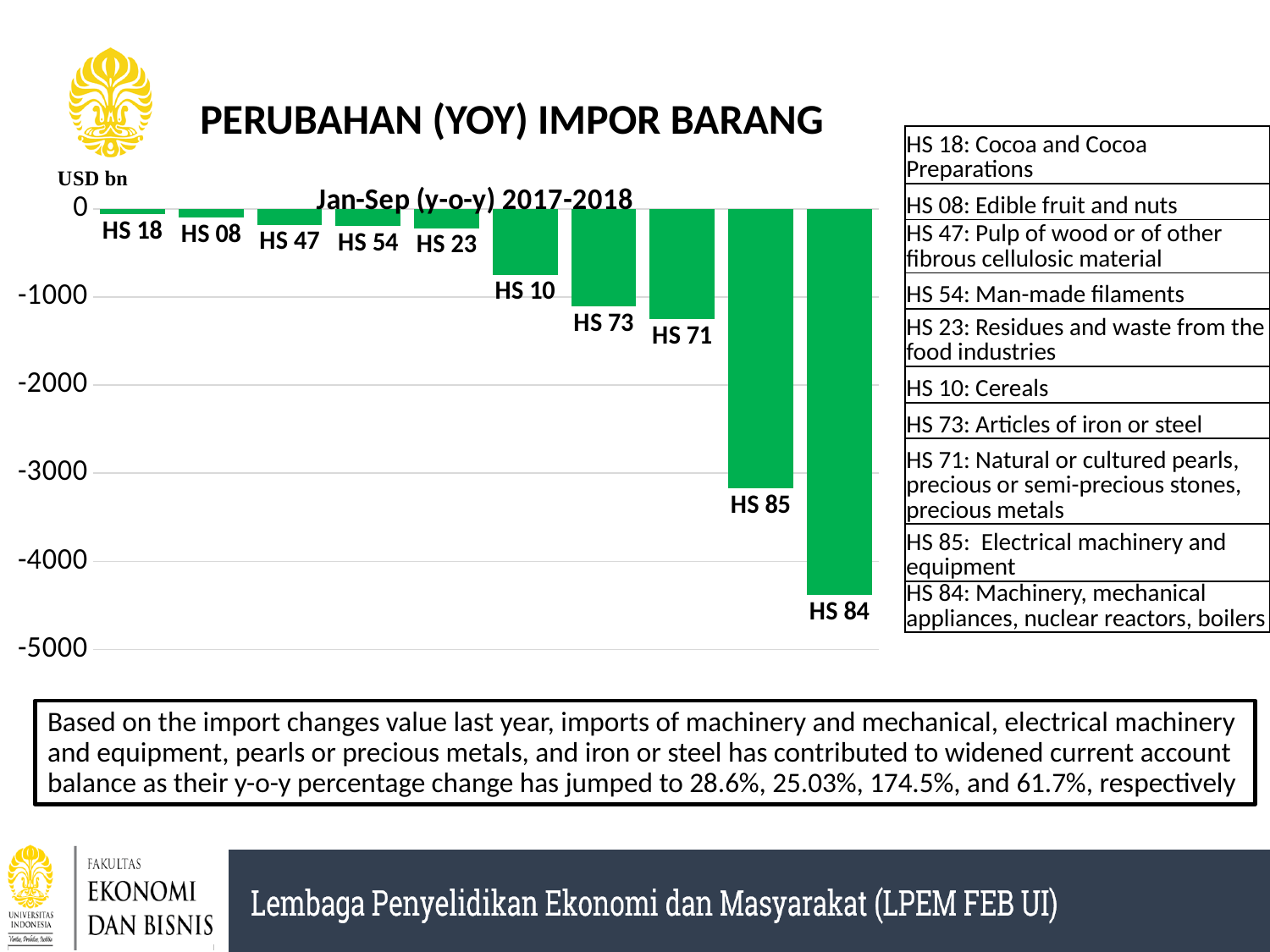
What kind of chart is shown on the slide? bar chart Which bar extends further below zero, HS 85 or HS 84? HS 84 Is the value for HS 84 greater or less than -4000? less Is the value for HS 85 greater or less than -3000? less What unit is shown on the vertical axis of the chart? USD bn Is the value for HS 23 greater or less than -1000? greater Do the values rise or fall moving from left to right along the x axis? fall How many HS categories are plotted in the chart? 10 Which has the larger (less negative) value, HS 10 or HS 71? HS 10 Which HS category has the lowest (most negative) value in the chart? HS 84